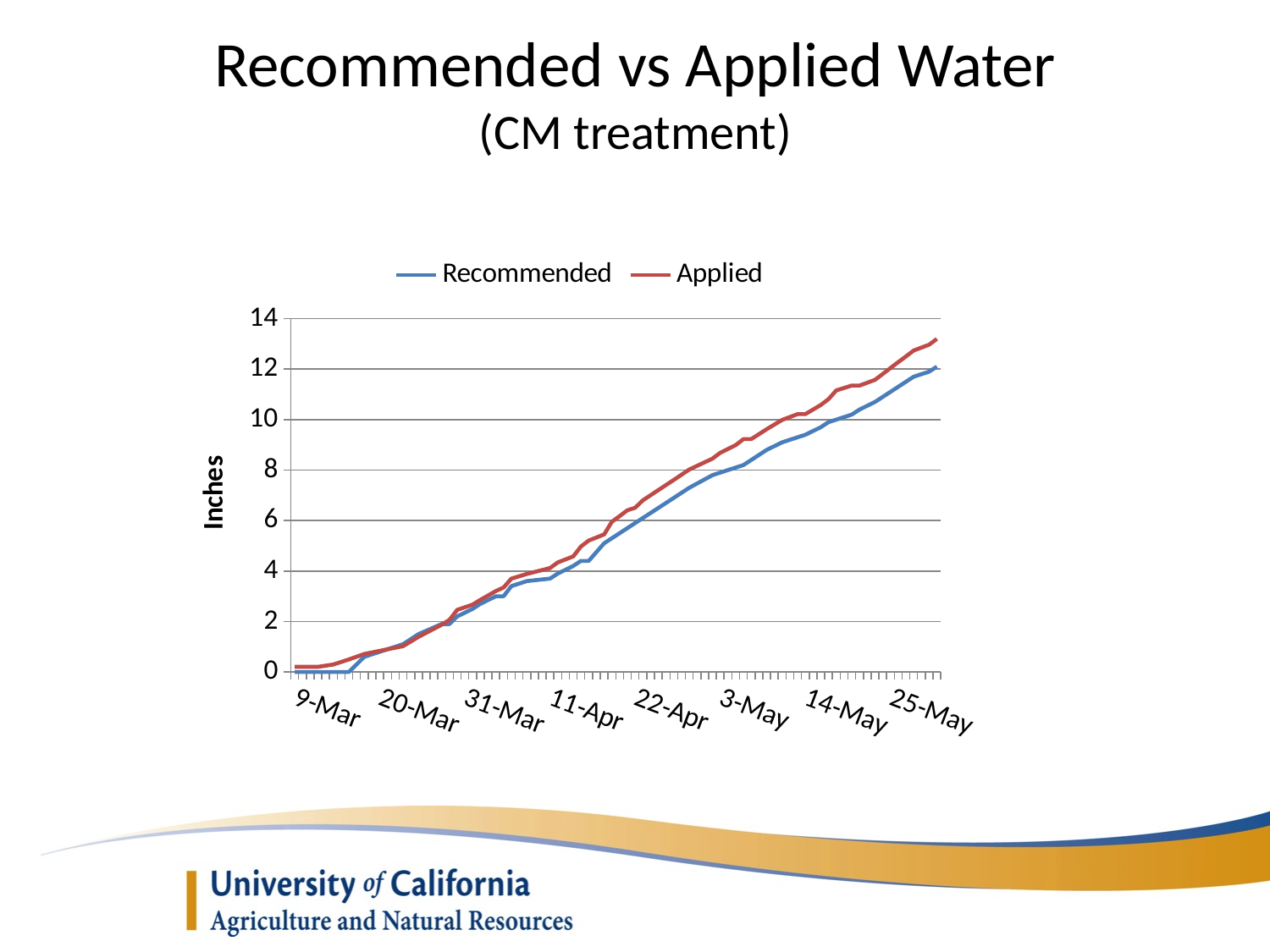
Do the Applied values rise or fall along the x axis? rise What kind of chart is shown on the slide? line chart Do the Recommended values rise or fall from 9-Mar to 25-May? rise Which series is plotted in red? Applied At 25-May, which series has the higher value, Recommended or Applied? Applied Is the Recommended value at 9-Mar greater or less than 2? less At 3-May, which series has the higher value, Recommended or Applied? Applied What is the label on the vertical axis? Inches How many series does the legend list? 2